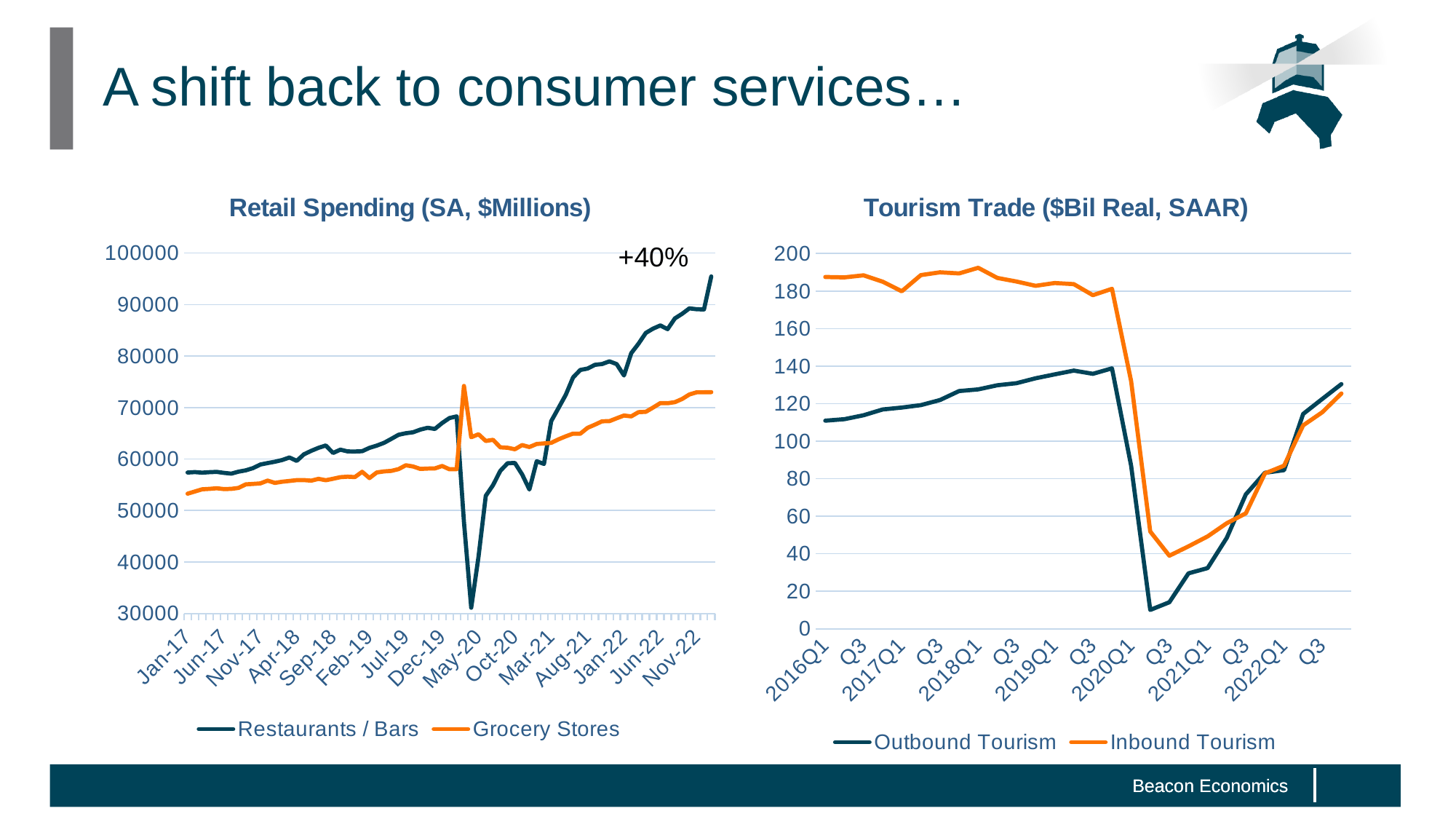
In the Tourism Trade ($Bil Real, SAAR) chart, is the Outbound Tourism value at 2020Q3 greater or less than 20? less In the Tourism Trade ($Bil Real, SAAR) chart, which series reaches the highest value shown? Inbound Tourism In the Retail Spending (SA, $Millions) chart, which series is higher at Jan-17, Restaurants / Bars or Grocery Stores? Restaurants / Bars In the Retail Spending (SA, $Millions) chart, is the lowest value of the Restaurants / Bars line around May-20 greater or less than 40000? less In the Retail Spending (SA, $Millions) chart, does the Grocery Stores line overall rise or fall from Jan-17 to Nov-22? rise In the Tourism Trade ($Bil Real, SAAR) chart, is the Outbound Tourism value at 2016Q1 greater or less than 120? less What kind of chart is the Retail Spending (SA, $Millions) chart? line chart In the Tourism Trade ($Bil Real, SAAR) chart, which series is higher at 2016Q1, Outbound Tourism or Inbound Tourism? Inbound Tourism How many series does the legend of the Tourism Trade ($Bil Real, SAAR) chart list? 2 How many series does the legend of the Retail Spending (SA, $Millions) chart list? 2 In the Retail Spending (SA, $Millions) chart, what percentage annotation is printed near the end of the Restaurants / Bars line? +40%